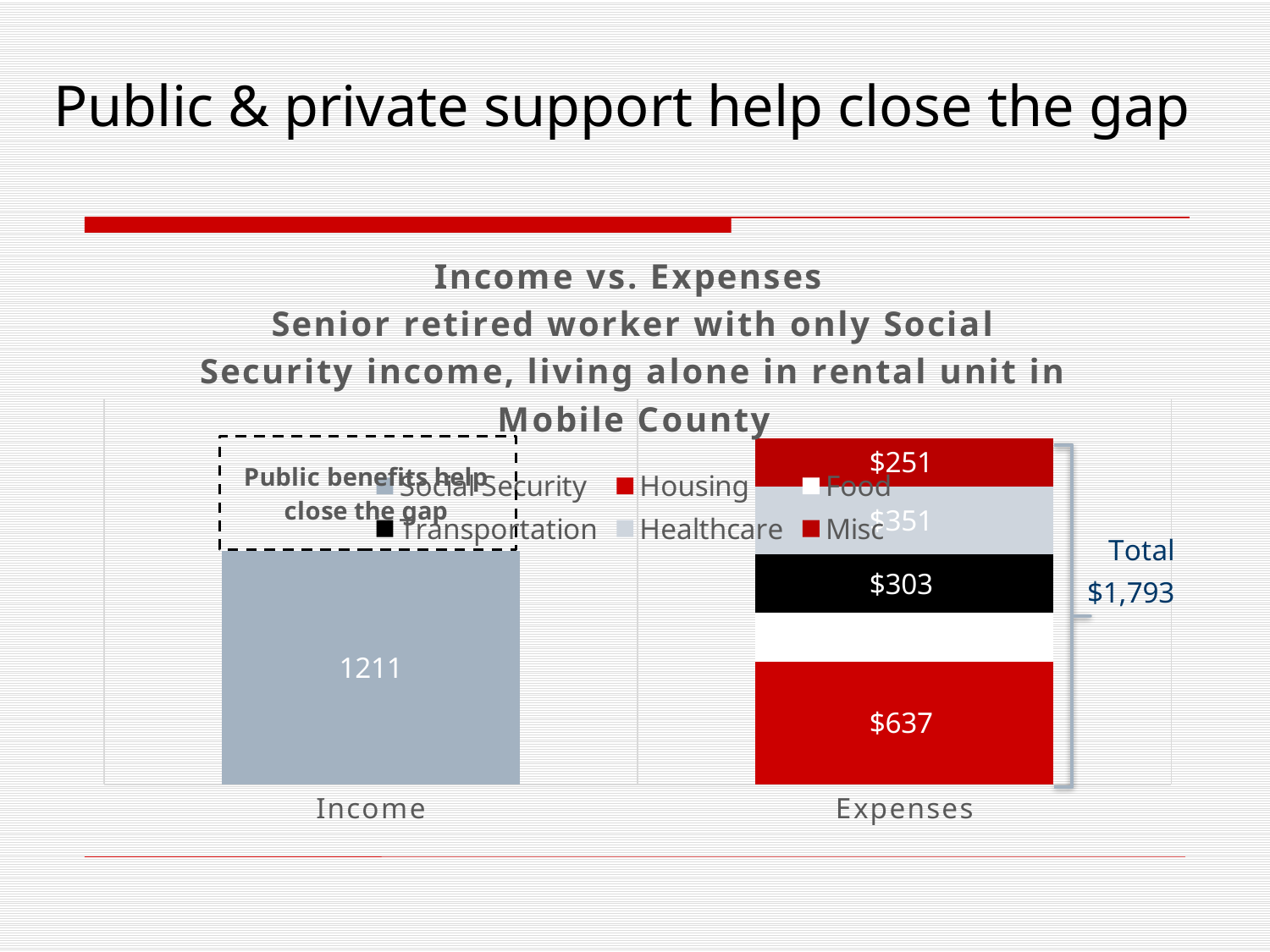
What is the value of the Misc segment in the Expenses bar? $251 What kind of chart is shown on the slide? Stacked bar chart What value is shown on the Income bar? 1211 What is the value of the Transportation segment in the Expenses bar? $303 Which is larger in the Expenses bar, Housing or Healthcare? Housing What is the value of the Housing segment in the Expenses bar? $637 What is the total of the Expenses bar? $1,793 What is the value of the Healthcare segment in the Expenses bar? $351 What is the difference between the Housing and Transportation segments in the Expenses bar? $334 How many series does the legend list? 6 How many categories are shown on the x axis? 2 Which segment of the Expenses bar is the largest? Housing